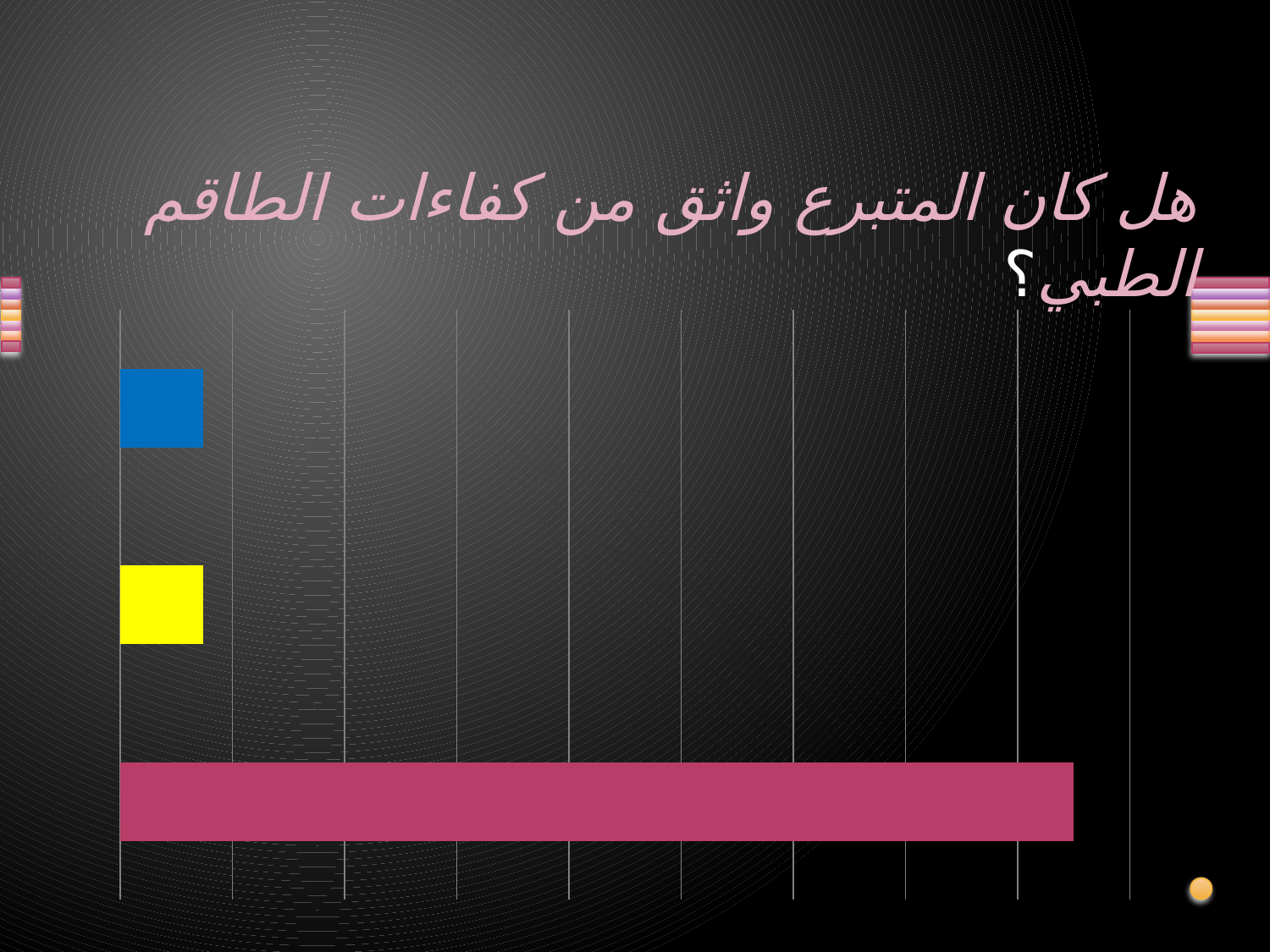
Which bar is the longest in the chart: the top (blue), middle (yellow) or bottom (pink) bar? the bottom (pink) bar How many bars are plotted in the chart? 3 Which is larger, the value of the middle (yellow) bar or the value of the bottom (pink) bar? the bottom (pink) bar Are the bars in the chart drawn horizontally or vertically? horizontally What is the title of the chart on the slide? هل كان المتبرع واثق من كفاءات الطاقم الطبي؟ What kind of chart is shown on the slide? bar chart Which is larger, the value of the bottom (pink) bar or the value of the top (blue) bar? the bottom (pink) bar